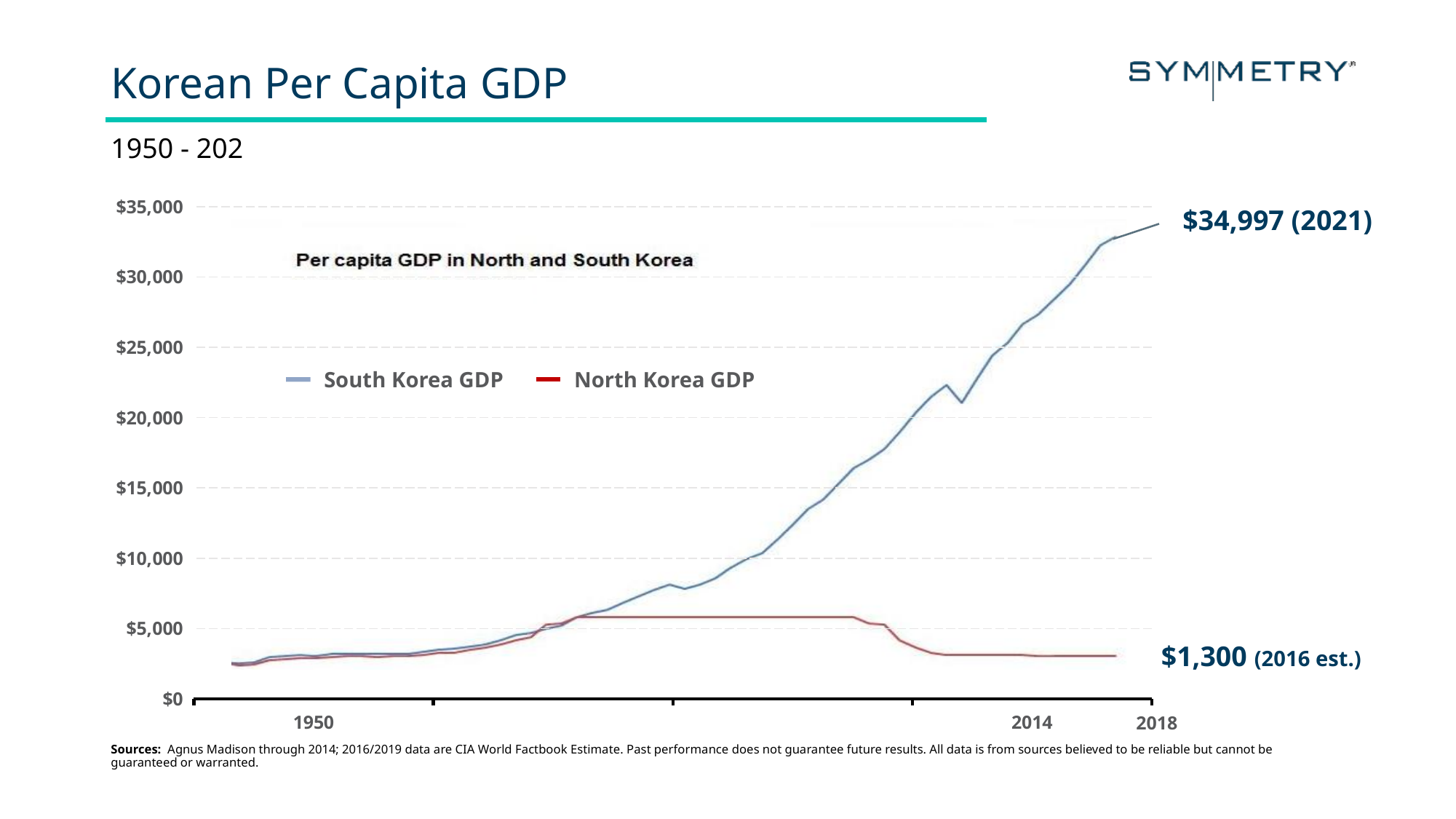
Which series reaches the highest value on the chart? South Korea GDP What is the labelled value for North Korea GDP (2016 est.)? $1,300 What is the difference between the labelled South Korea GDP ($34,997) and the labelled North Korea GDP ($1,300)? $33,697 Is the value for South Korea GDP in 2014 greater or less than $25,000? greater Is the peak value for North Korea GDP greater or less than $10,000? less What colour is the North Korea GDP line? Red What kind of chart is shown on the slide? Line chart Which series ends at a higher value, South Korea GDP or North Korea GDP? South Korea GDP Does South Korea GDP rise or fall from 1950 to 2018? Rise How many series does the legend list? 2 What is the title printed inside the chart area? Per capita GDP in North and South Korea What is the labelled value for South Korea GDP in 2021? $34,997